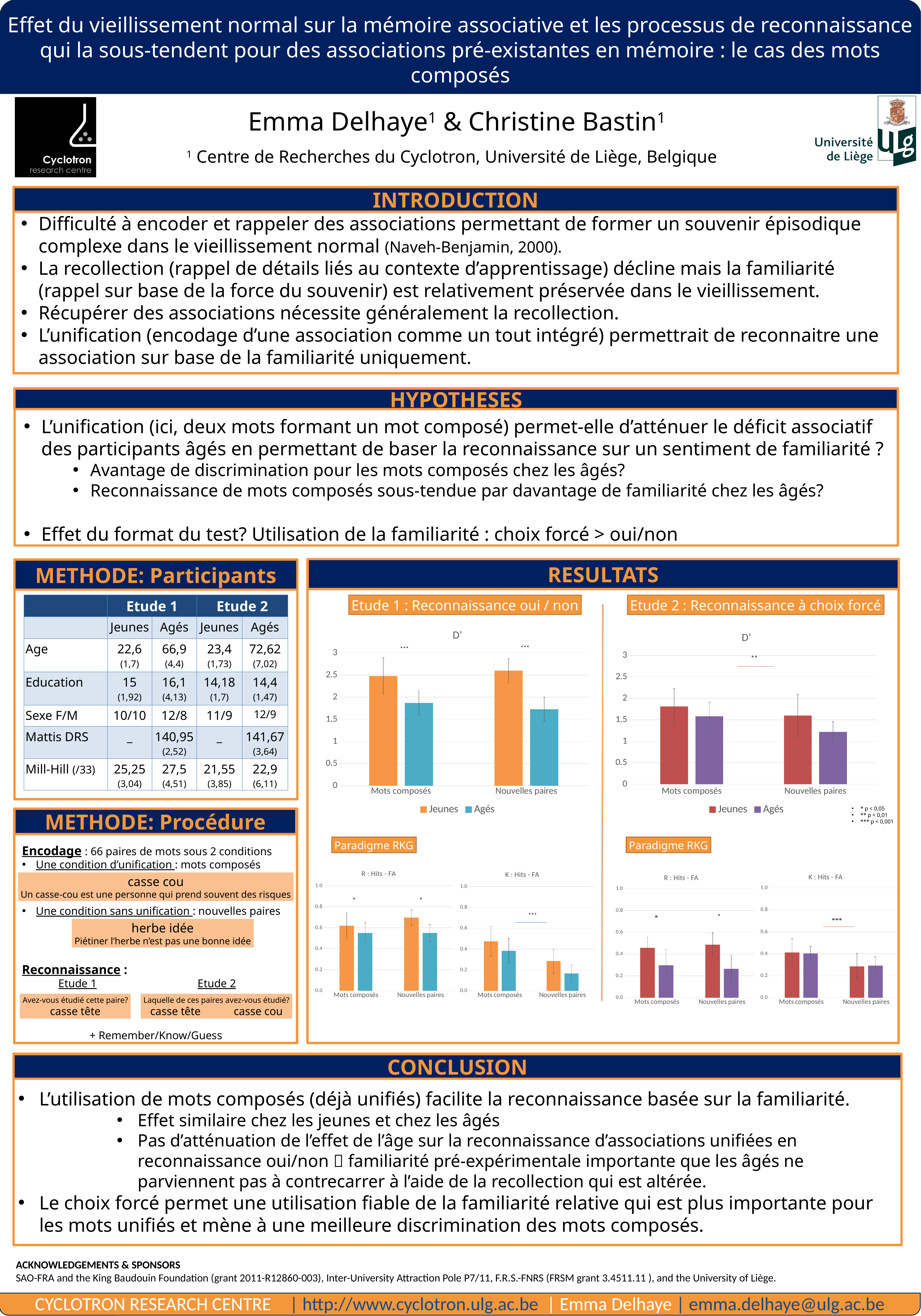
In the Etude 2 D' chart (Reconnaissance à choix forcé), is the value for Jeunes on Mots composés greater or less than 1.5? greater In the Etude 2 R : Hits - FA chart (Paradigme RKG), is the value for Jeunes on Mots composés greater or less than 0.4? greater In the Etude 1 D' chart (Reconnaissance oui / non), which series has the larger value for Nouvelles paires, Jeunes or Agés? Jeunes In the Etude 2 D' chart (Reconnaissance à choix forcé), is the value for Agés on Nouvelles paires greater or less than 1.5? less In the Etude 1 K : Hits - FA chart (Paradigme RKG), which category has the larger value for Jeunes, Mots composés or Nouvelles paires? Mots composés In the Etude 1 D' chart (Reconnaissance oui / non), what kind of chart is shown? bar chart In the Etude 2 D' chart (Reconnaissance à choix forcé), which series is shown in purple? Agés In the Etude 1 D' chart (Reconnaissance oui / non), how many series does the legend list? 2 In the Etude 1 D' chart (Reconnaissance oui / non), how many categories are shown on the x axis? 2